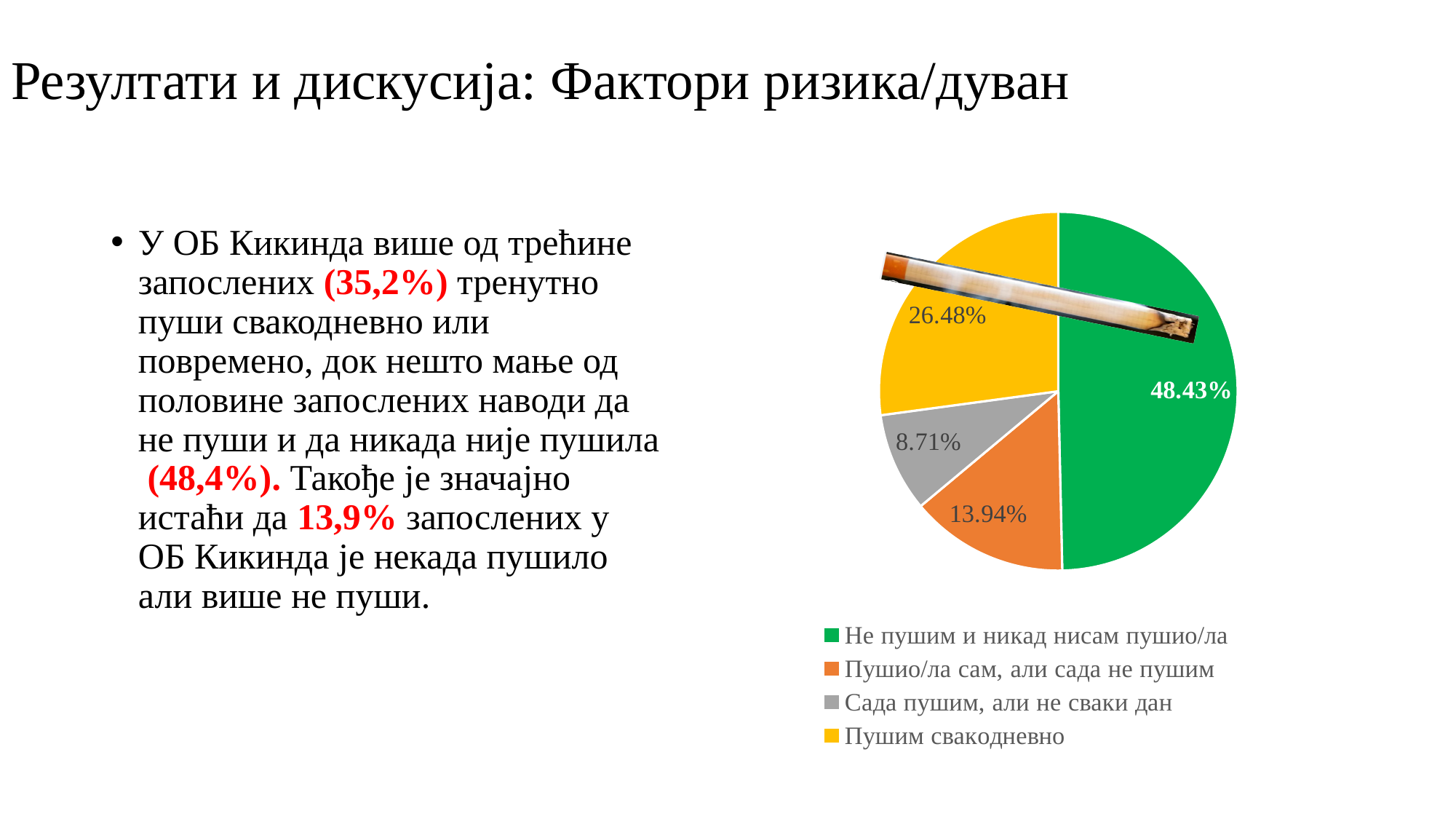
What colour is the slice for "Пушим свакодневно"? yellow What share of the pie does "Не пушим и никад нисам пушио/ла" have? 48.43% What is the difference in percentage points between "Пушим свакодневно" and "Пушио/ла сам, али сада не пушим"? 12.54 How many slices does the pie chart have? 4 What share of the pie does "Пушио/ла сам, али сада не пушим" have? 13.94% What share of the pie does "Пушим свакодневно" have? 26.48% Which category has the smallest slice of the pie? Сада пушим, али не сваки дан Which category has the largest slice of the pie? Не пушим и никад нисам пушио/ла Which legend entry is shown in green? Не пушим и никад нисам пушио/ла What kind of chart is shown on the slide? pie chart Which is larger: the slice for "Пушим свакодневно" or the slice for "Сада пушим, али не сваки дан"? Пушим свакодневно What share of the pie does "Сада пушим, али не сваки дан" have? 8.71%